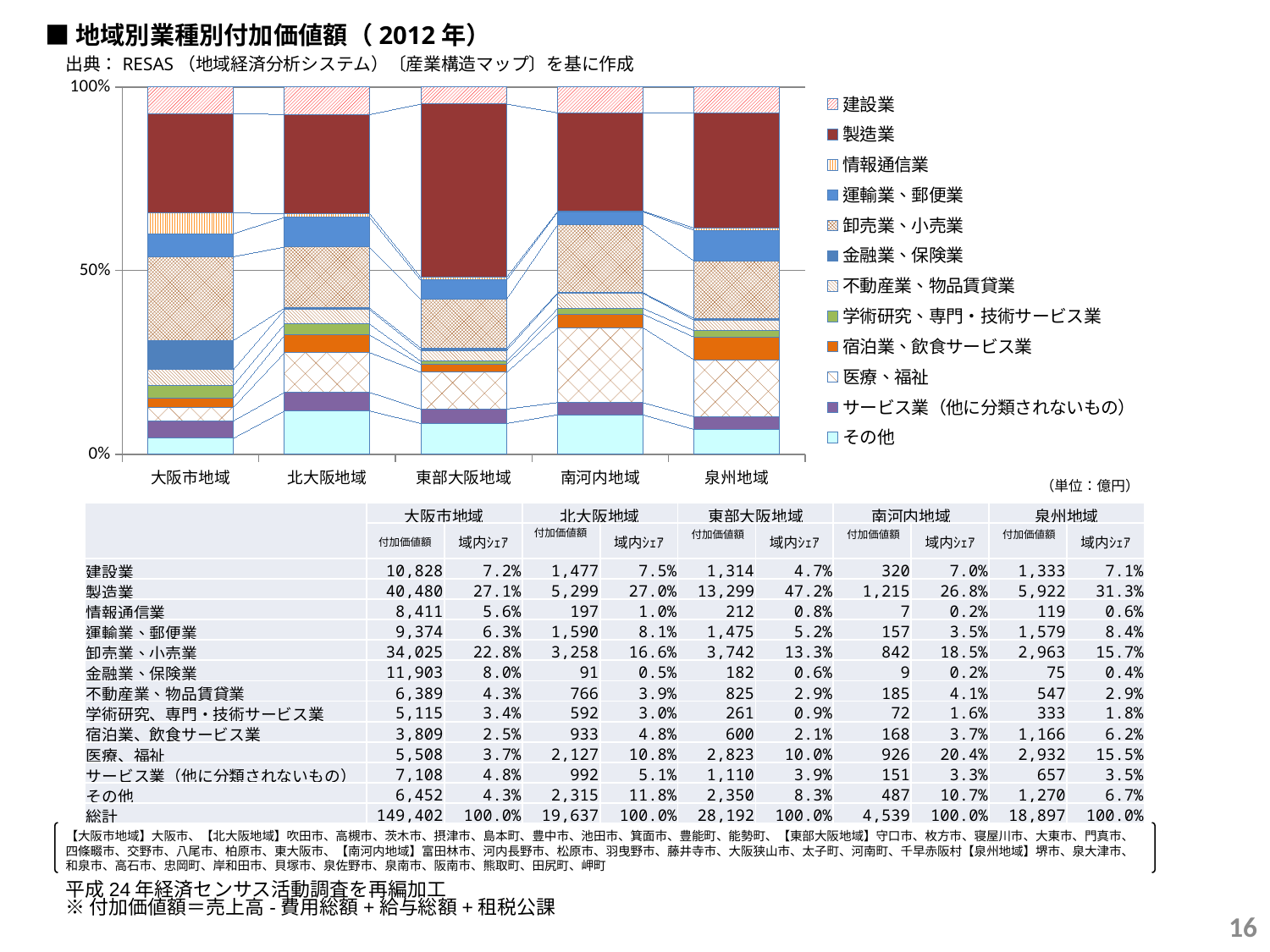
What kind of chart is shown on the slide? stacked bar chart What is the 総計 付加価値額 for 大阪市地域? 149,402 What is the 域内シェア of 製造業 in 東部大阪地域? 47.2% Which has the larger 域内シェア for 卸売業、小売業: 大阪市地域 or 北大阪地域? 大阪市地域 Which region has the highest 域内シェア for 製造業? 東部大阪地域 Which industry is listed first in the chart legend? 建設業 Is the 製造業 域内シェア for 泉州地域 greater or less than 50%? less Which region has the lowest 域内シェア for 情報通信業? 南河内地域 How many regions (categories) are plotted along the x axis of the chart? 5 What is the 域内シェア of 医療、福祉 in 南河内地域? 20.4% What is the difference in 製造業 域内シェア between 東部大阪地域 and 泉州地域? 15.9 percentage points How many industry series does the chart legend list? 12